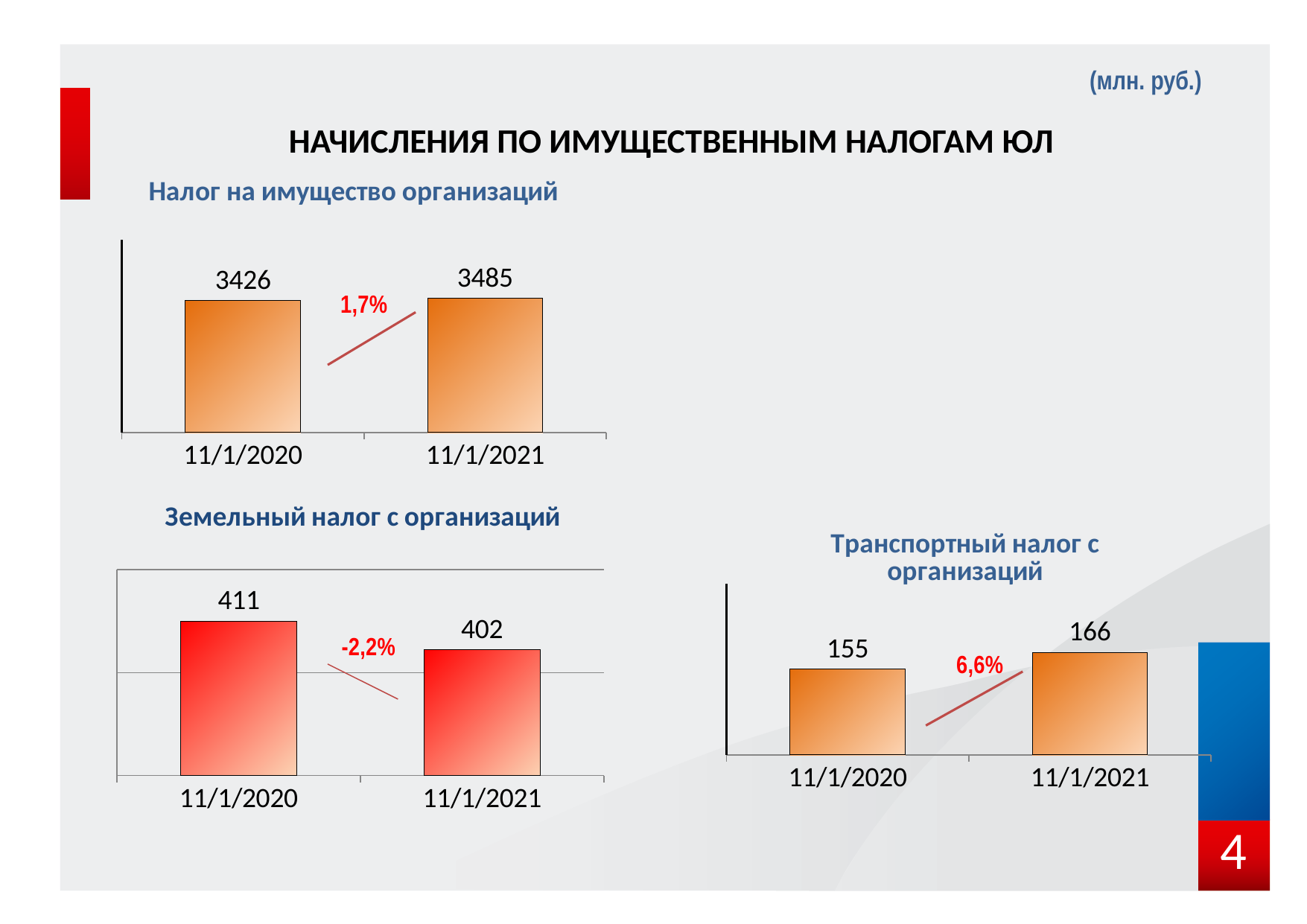
In the chart titled "Земельный налог с организаций", what is the difference between the 11/1/2020 and 11/1/2021 values? 9 In the chart titled "Земельный налог с организаций", what is the value for 11/1/2020? 411 In the chart titled "Налог на имущество организаций", what is the value for 11/1/2021? 3485 How many bars are shown in the chart titled "Транспортный налог с организаций"? 2 In the chart titled "Транспортный налог с организаций", which date has the higher value? 11/1/2021 In the chart titled "Налог на имущество организаций", what is the value for 11/1/2020? 3426 In the chart titled "Транспортный налог с организаций", what is the value for 11/1/2021? 166 In the chart titled "Налог на имущество организаций", what is the difference between the 11/1/2021 and 11/1/2020 values? 59 What type of chart is the chart titled "Налог на имущество организаций"? bar chart In the chart titled "Земельный налог с организаций", which date has the lower value? 11/1/2021 In the chart titled "Земельный налог с организаций", do the values rise or fall from 11/1/2020 to 11/1/2021? fall In the chart titled "Транспортный налог с организаций", what is the difference between the 11/1/2021 and 11/1/2020 values? 11